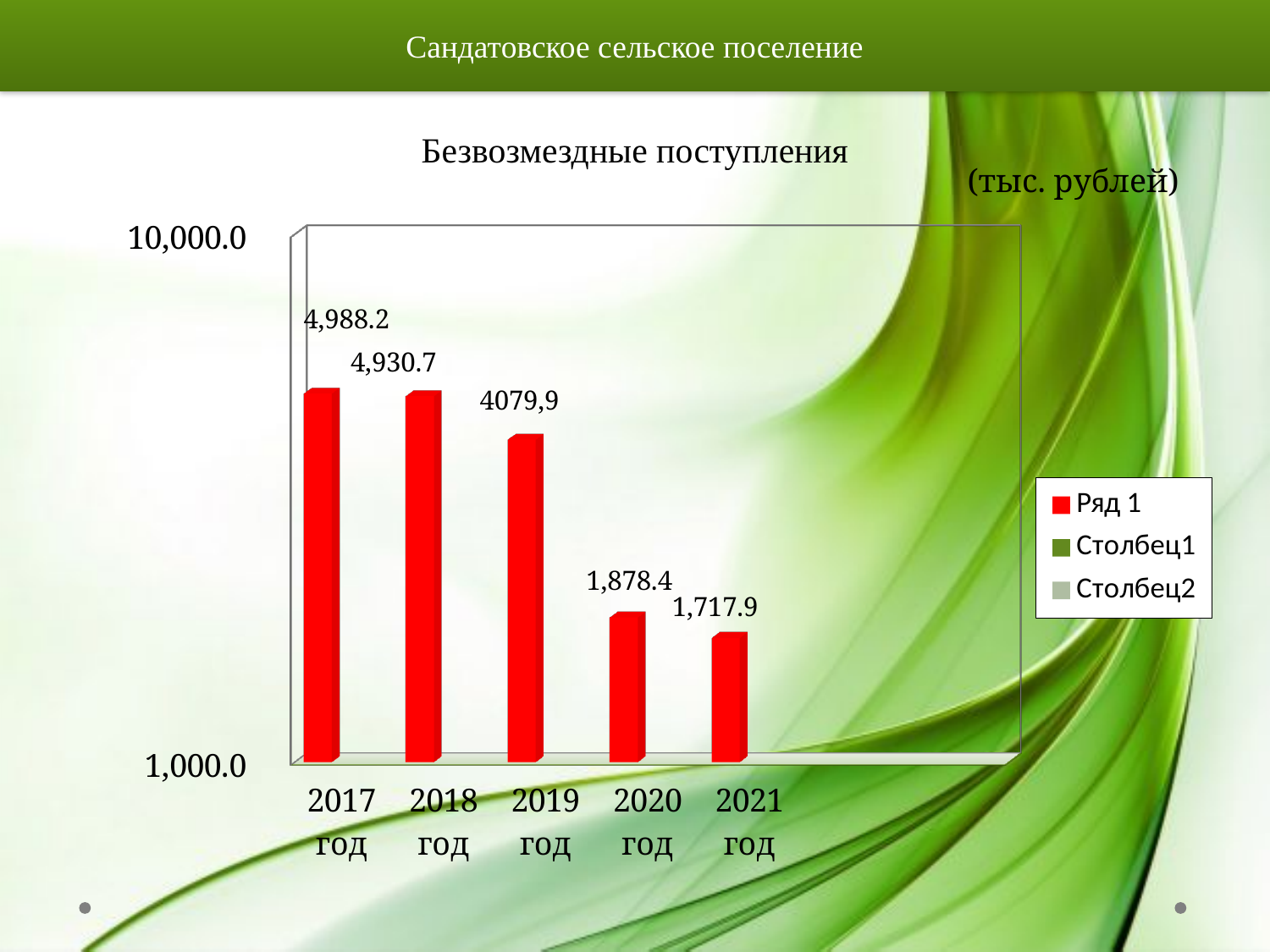
What is the value for 2017 год in the chart? 4,988.2 Which is larger, the value for 2018 год or the value for 2019 год? 2018 год Which year has the highest value in the chart? 2017 год Which year has the lowest value in the chart? 2021 год What is the value for 2021 год in the chart? 1,717.9 What is the difference between the values for 2020 год and 2021 год? 160.5 What is the value for 2019 год in the chart? 4079,9 What kind of chart is shown on the slide? bar chart What is the value for 2020 год in the chart? 1,878.4 Do the values rise or fall from 2017 год to 2021 год? fall How many series does the legend list? 3 How many years are shown on the x axis of the chart? 5